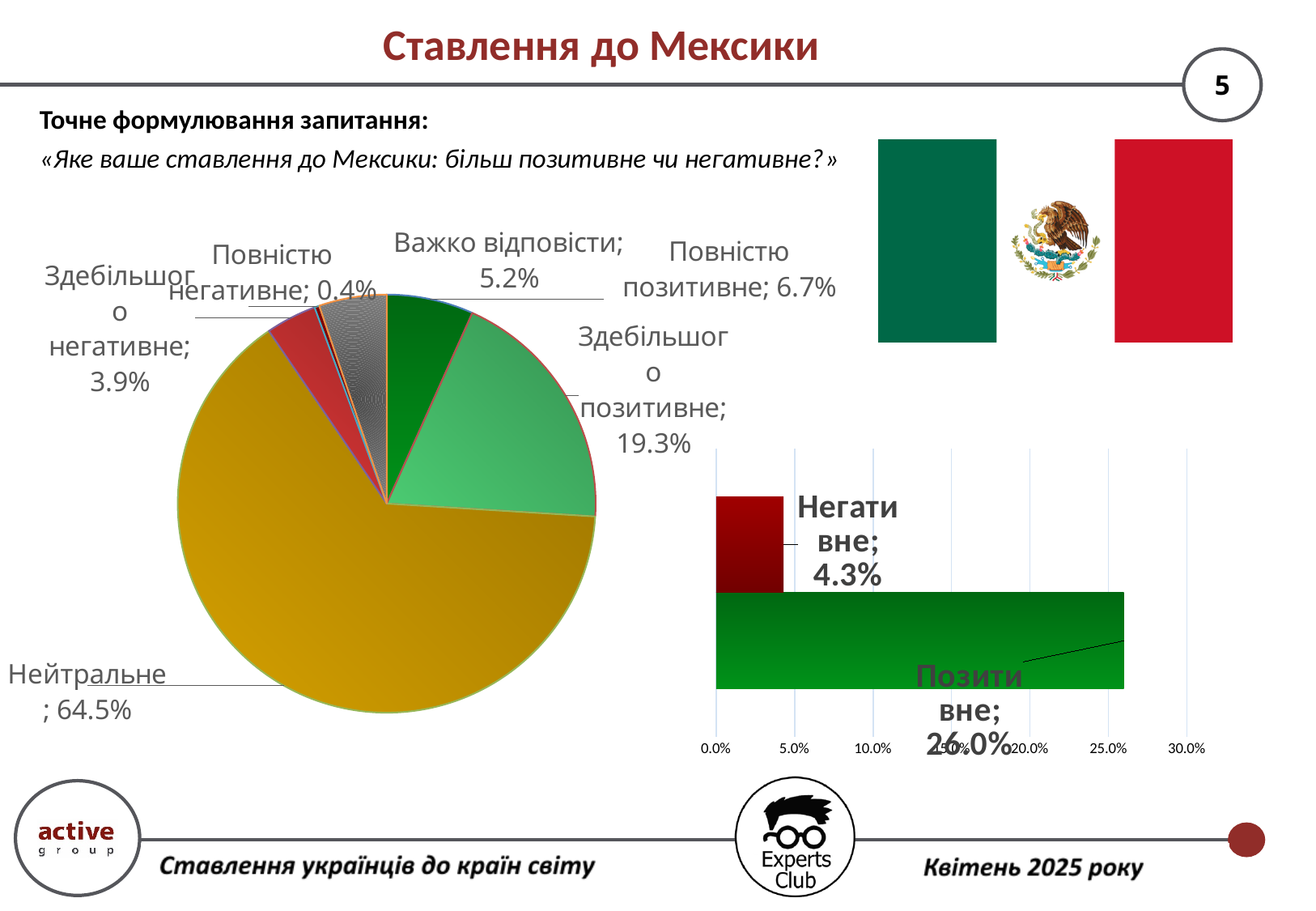
In the pie chart on the left, which is larger: "Важко відповісти" or "Здебільшого негативне"? Важко відповісти What type of chart is shown on the right side of the slide? Bar chart In the pie chart on the left, what is the value for "Повністю негативне"? 0.4% In the bar chart on the right, what is the difference between "Позитивне" and "Негативне"? 21.7% How many slices does the pie chart on the left have? 6 In the pie chart on the left, which category has the smallest share? Повністю негативне In the bar chart on the right, what is the value for "Негативне"? 4.3% In the pie chart on the left, what is the value for "Нейтральне"? 64.5% In the pie chart on the left, which category has the largest share? Нейтральне In the bar chart on the right, what is the value for "Позитивне"? 26.0% In the pie chart on the left, what is the difference between "Здебільшого позитивне" and "Повністю позитивне"? 12.6% In the pie chart on the left, what is the value for "Здебільшого позитивне"? 19.3%